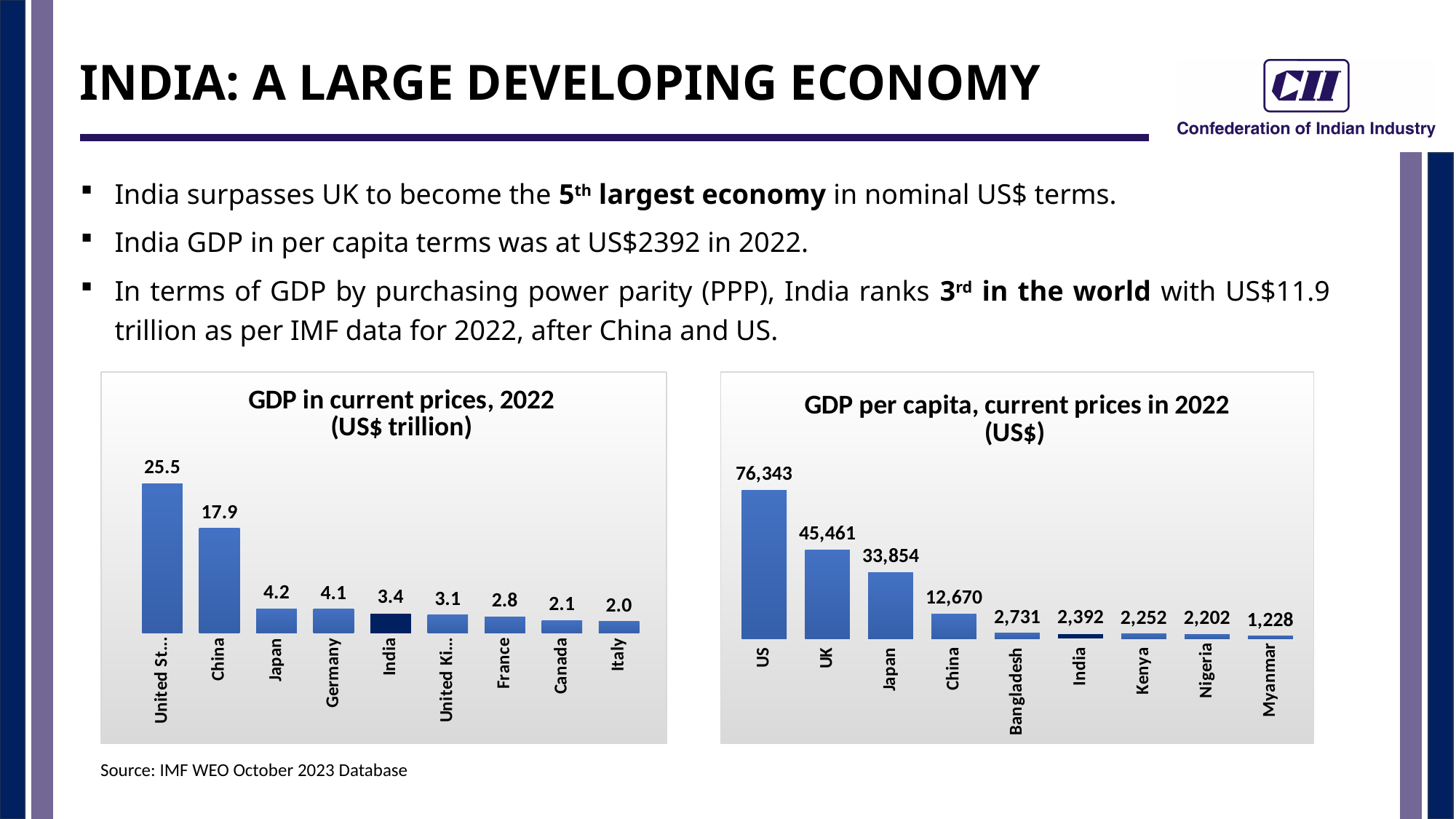
In the 'GDP in current prices, 2022 (US$ trillion)' chart, which country has the lowest value? Italy In the 'GDP in current prices, 2022 (US$ trillion)' chart, what is the value for China? 17.9 What type of chart is the 'GDP per capita, current prices in 2022 (US$)' chart? Bar chart In the 'GDP per capita, current prices in 2022 (US$)' chart, what is the value for India? 2,392 In the 'GDP in current prices, 2022 (US$ trillion)' chart, what is the value for India? 3.4 In the 'GDP per capita, current prices in 2022 (US$)' chart, which country has the highest value? US In the 'GDP in current prices, 2022 (US$ trillion)' chart, which is larger, France or Canada? France In the 'GDP per capita, current prices in 2022 (US$)' chart, do the values rise or fall from left to right? Fall In the 'GDP per capita, current prices in 2022 (US$)' chart, which country has the lowest value? Myanmar How many countries are shown in the 'GDP in current prices, 2022 (US$ trillion)' chart? 9 In the 'GDP per capita, current prices in 2022 (US$)' chart, what is the difference between the US and the UK? 30,882 In the 'GDP in current prices, 2022 (US$ trillion)' chart, what is the difference between Japan and Germany? 0.1